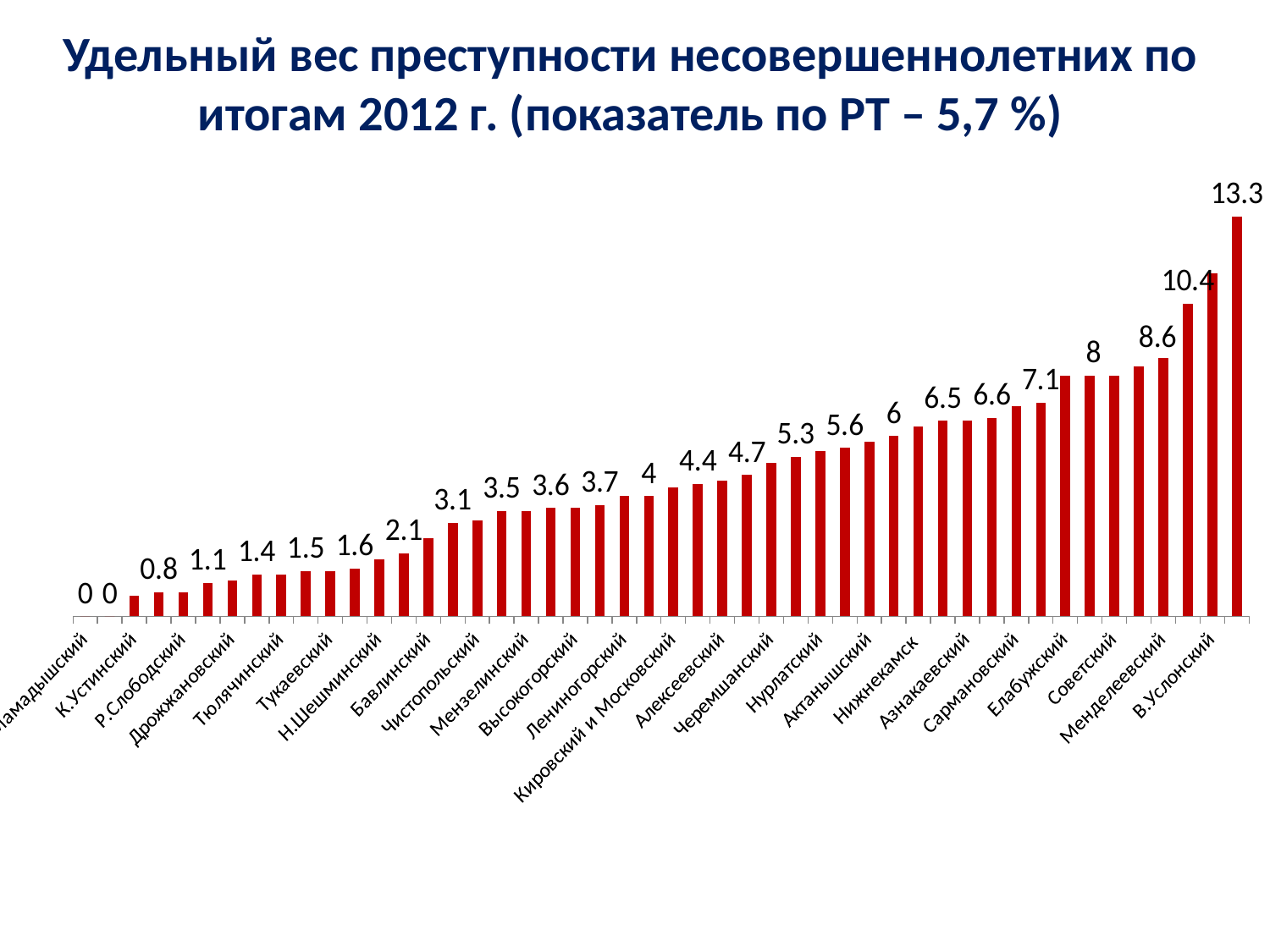
According to the chart title, what is the indicator for RT (Republic of Tatarstan)? 5,7 % Which is larger, the value for В.Услонский or the value for К.Устинский? В.Услонский Which is larger, the value for Менделеевский or the value for Тукаевский? Менделеевский What year do the results in the chart title refer to? 2012 Do the values rise or fall from left to right along the x axis? rise What is the highest value labelled on the chart? 13.3 Which is larger, the value for Нижнекамск or the value for Бавлинский? Нижнекамск What kind of chart is shown on the slide? bar chart